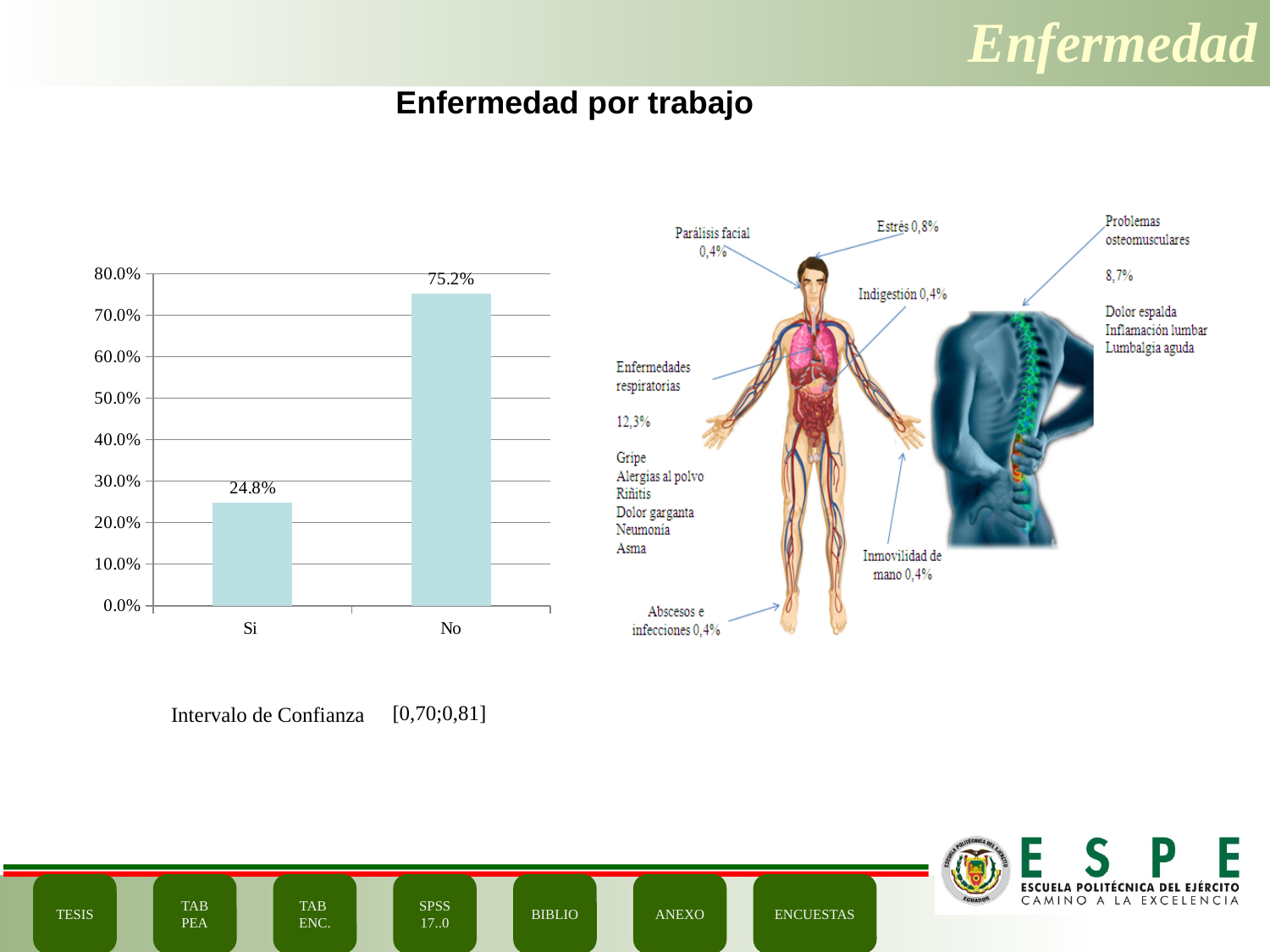
Which category has the highest value in the bar chart? No What is the value for "Si" in the bar chart? 24.8% What is the value for "No" in the bar chart? 75.2% What is the highest value shown on the y axis of the bar chart? 80.0% Is the value for "Si" in the bar chart greater or less than 30.0%? less What is the difference between the values for "No" and "Si" in the bar chart? 50.4% Which category has the lowest value in the bar chart? Si What is the title of the chart on the slide? Enfermedad por trabajo Which is larger in the bar chart, the value for "Si" or the value for "No"? No How many categories are shown in the bar chart? 2 Is the value for "No" in the bar chart greater or less than 70.0%? greater What kind of chart is shown on the slide? bar chart